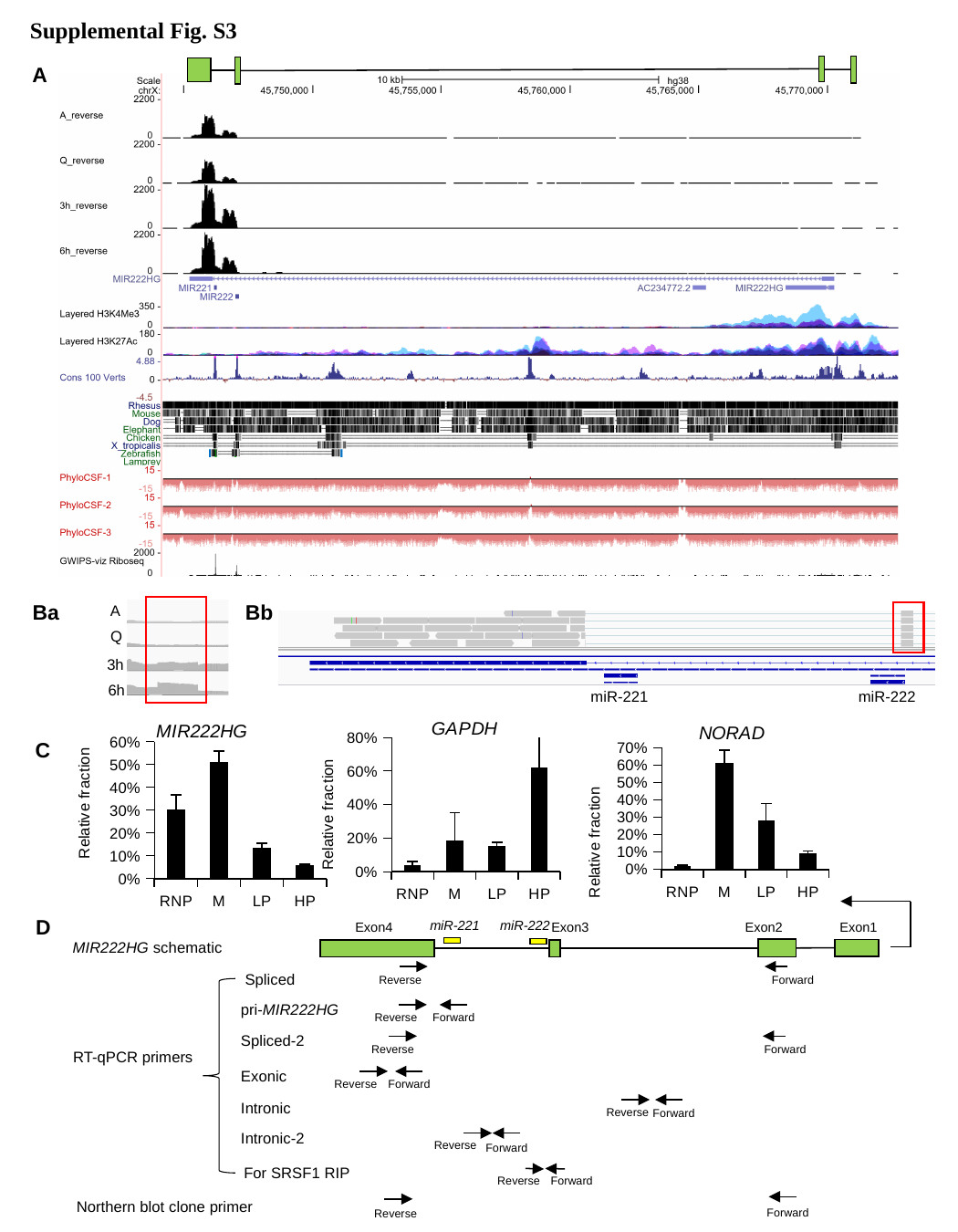
In the MIR222HG chart, which is larger, the value for RNP or the value for LP? RNP In the GAPDH chart, which category has the highest relative fraction? HP In the NORAD chart, is the value for M greater or less than 50%? greater In the MIR222HG chart, is the value for HP greater or less than 10%? less How many categories are shown on the x axis of the GAPDH chart? 4 In the GAPDH chart, is the value for HP greater or less than 40%? greater In the NORAD chart, which category has the lowest relative fraction? RNP In the MIR222HG chart, which category has the lowest relative fraction? HP What kind of chart is the NORAD chart in panel C? bar chart In the NORAD chart, which is larger, the value for LP or the value for HP? LP In the MIR222HG chart, which category has the highest relative fraction? M